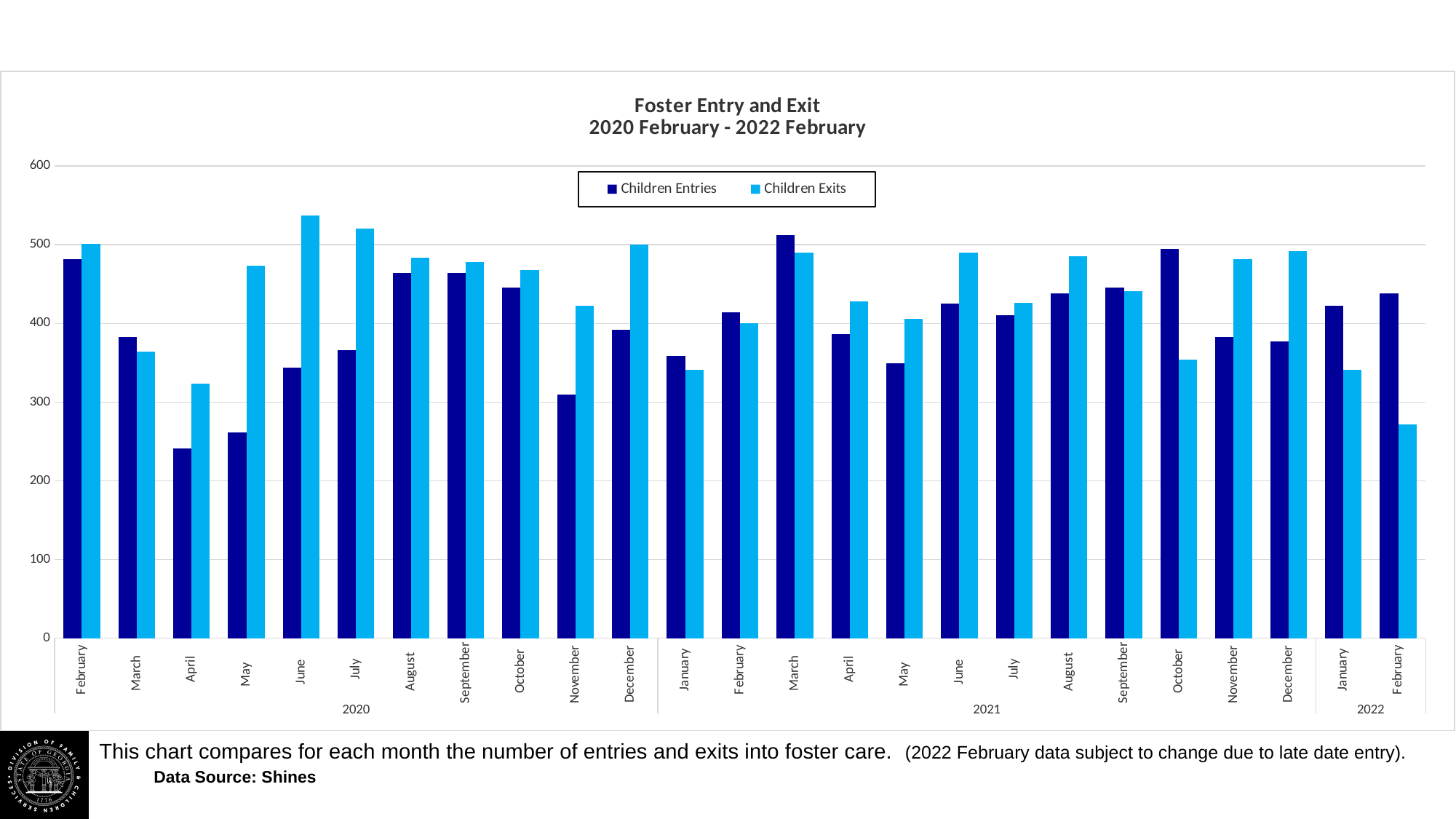
What type of chart is shown on the slide? bar chart In which month are Children Entries highest? March 2021 In which month are Children Exits lowest? February 2022 Is the value for Children Entries in November 2020 greater or less than 350? less How many series does the legend list? 2 In which month are Children Entries lowest? April 2020 What are the two series named in the legend? Children Entries and Children Exits Is the value for Children Exits in June 2020 greater or less than 500? greater In June 2020, which is larger: Children Entries or Children Exits? Children Exits In October 2021, which is larger: Children Entries or Children Exits? Children Entries How many months are plotted on the x axis? 25 Is the value for Children Entries in April 2020 greater or less than 300? less